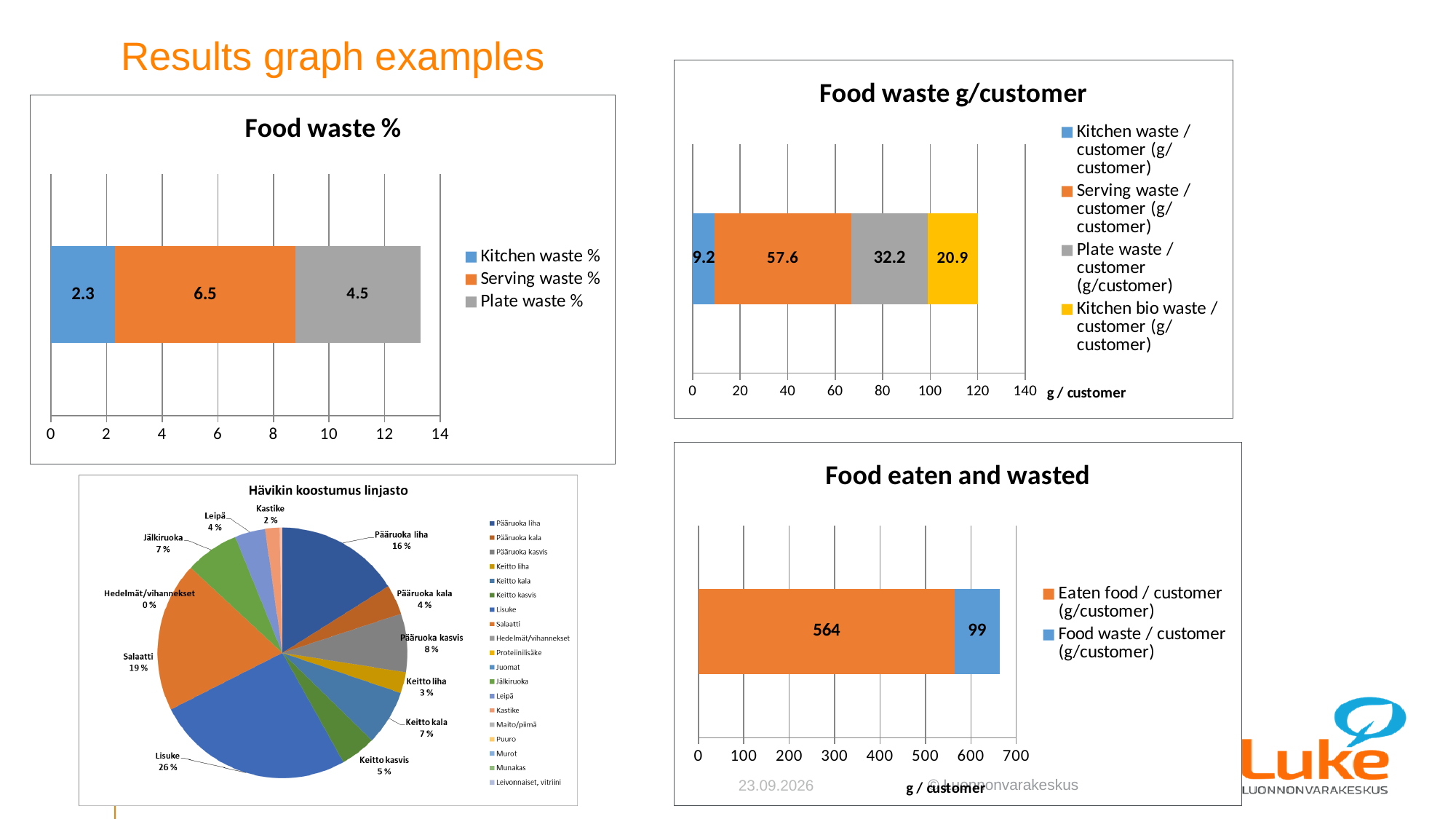
In the 'Food waste %' chart, what is the value for Serving waste %? 6.5 How many series does the legend of the 'Food waste g/customer' chart list? 4 In the 'Food waste %' chart, what is the total of the stacked bar? 13.3 In the 'Food waste %' chart, which series has the lowest value? Kitchen waste % In the pie chart 'Hävikin koostumus linjasto', which of Salaatti and Pääruoka liha has the larger share? Salaatti In the 'Food waste g/customer' chart, which series has the highest value? Serving waste / customer (g/customer) In the 'Food eaten and wasted' chart, what is the total of the stacked bar? 663 In the pie chart 'Hävikin koostumus linjasto', what share does Lisuke have? 26 % In the 'Food waste g/customer' chart, what is the difference between Serving waste / customer and Kitchen bio waste / customer? 36.7 In the 'Food waste g/customer' chart, what is the value for Plate waste / customer? 32.2 In the 'Food eaten and wasted' chart, what is the value for Eaten food / customer? 564 What kind of chart is 'Food eaten and wasted'? Stacked bar chart